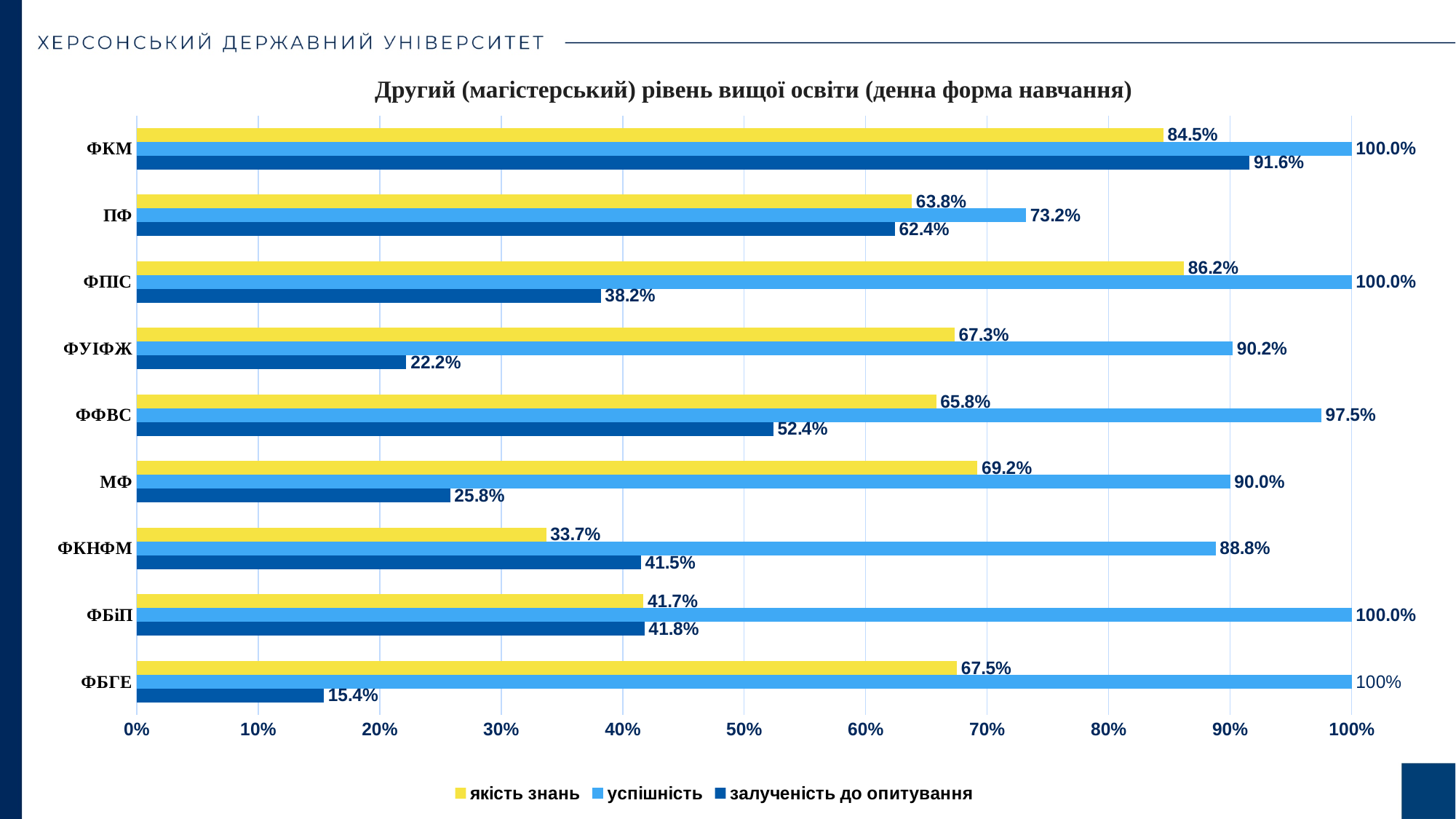
What is the value of залученість до опитування for ФУІФЖ? 22.2% How many categories (faculties) are shown on the chart? 9 Which category has the lowest value for залученість до опитування? ФБГЕ How many series does the legend list? 3 Which category has the lowest value for якість знань? ФКНФМ For ФКНФМ, which is larger: якість знань or залученість до опитування? залученість до опитування What is the title of the chart? Другий (магістерський) рівень вищої освіти (денна форма навчання) What kind of chart is shown on the slide? bar chart What is the value of якість знань for ФПІС? 86.2% Which category has the highest value for якість знань? ФПІС What is the value of успішність for ПФ? 73.2% What is the difference between успішність and залученість до опитування for ФКМ? 8.4 percentage points